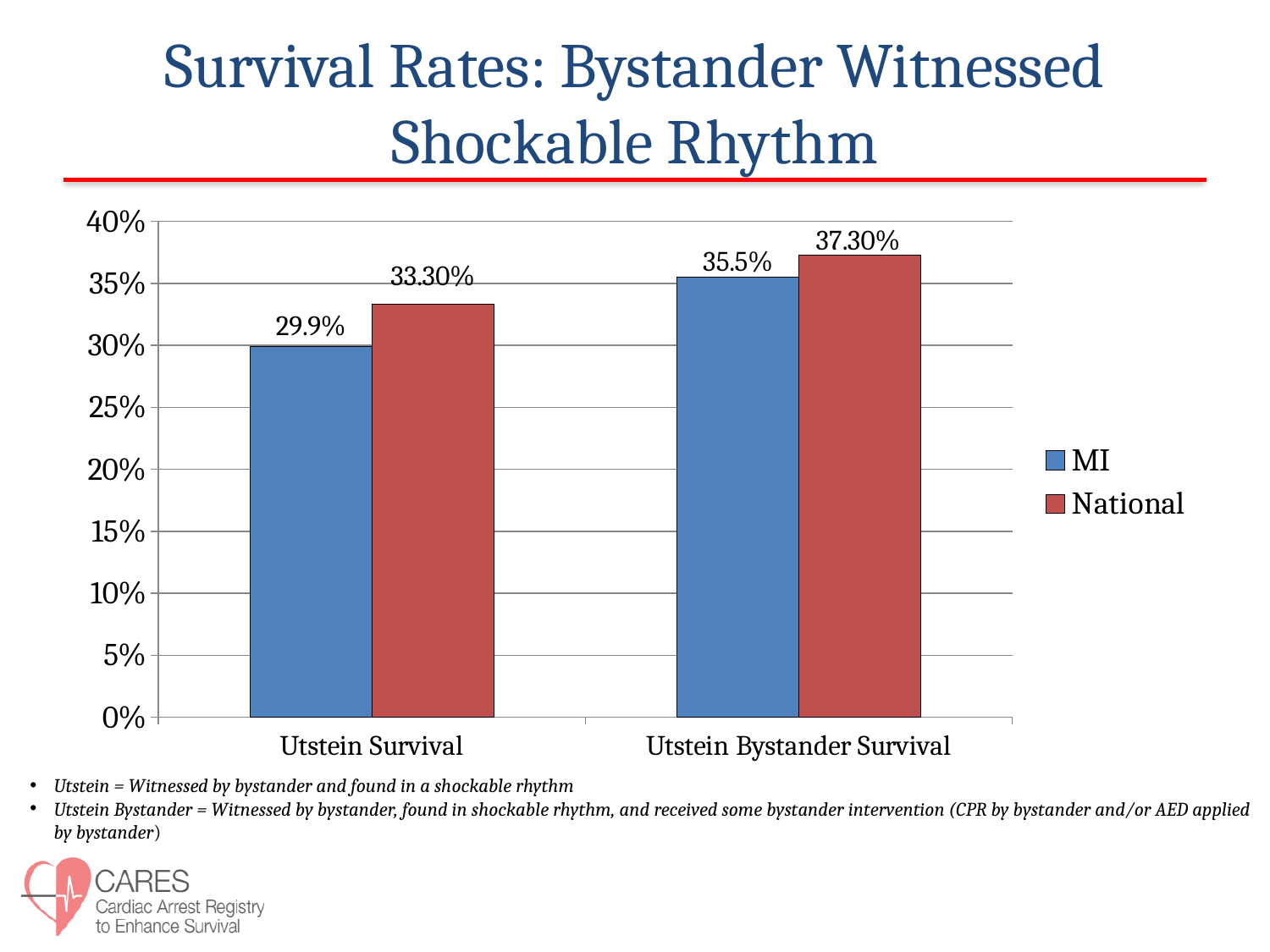
For Utstein Bystander Survival, which is larger, the MI value or the National value? National What is the MI value for Utstein Bystander Survival? 35.5% What is the National value for Utstein Survival? 33.30% Is the MI value for Utstein Survival greater or less than 30%? less Which category has the lowest MI value? Utstein Survival How many series does the legend list? 2 What is the National value for Utstein Bystander Survival? 37.30% What is the MI value for Utstein Survival? 29.9% Which category has the highest National value? Utstein Bystander Survival What is the difference between the National and MI values for Utstein Survival, in percentage points? 3.4 What kind of chart is shown on the slide? bar chart How many categories are shown on the x axis? 2